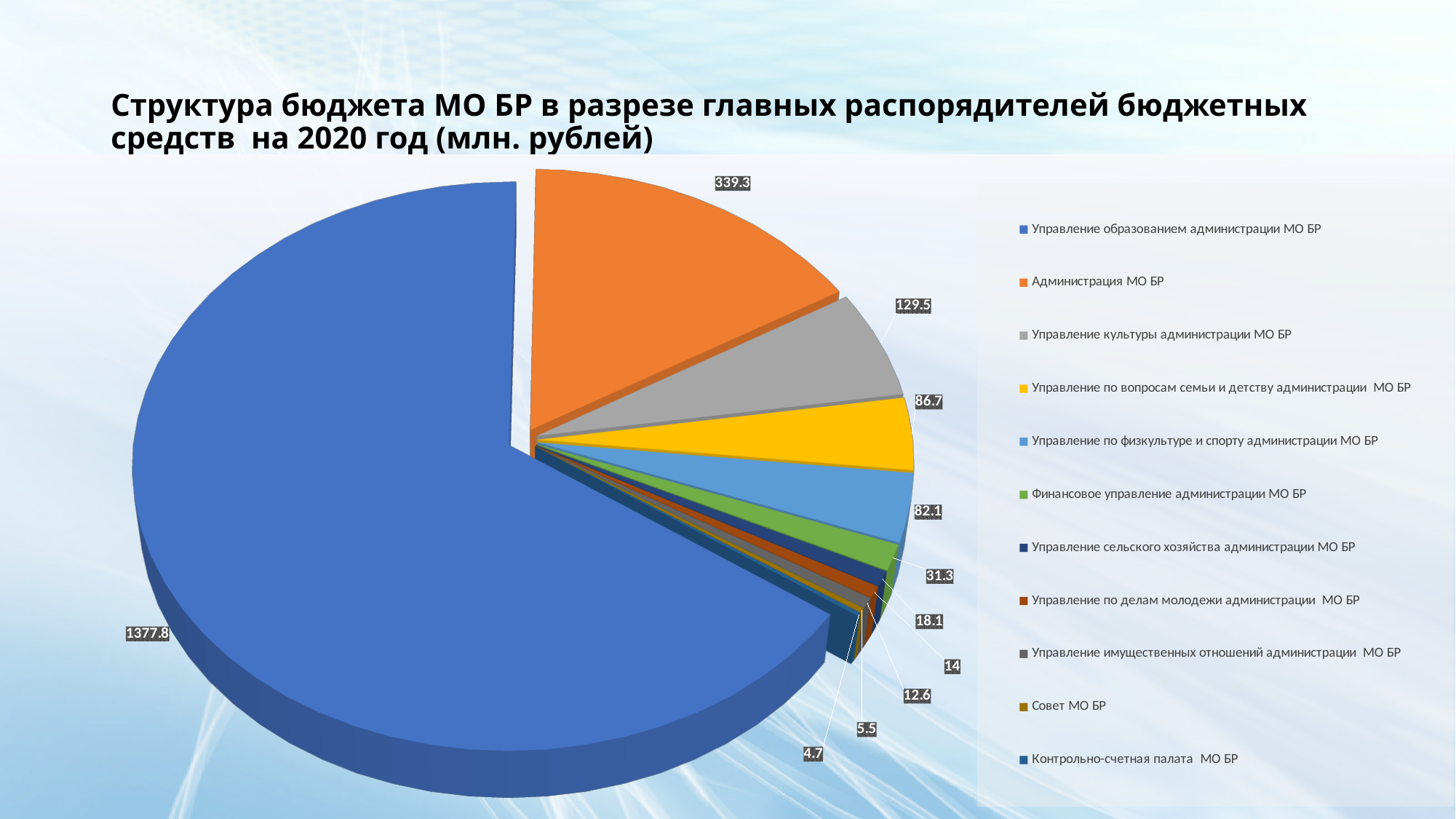
What is the value for Администрация МО БР? 339.3 What unit is stated in the chart title for the values? млн. рублей What is the value for Контрольно-счетная палата МО БР? 4.7 Which is larger: the value for Управление по вопросам семьи и детству администрации МО БР or Финансовое управление администрации МО БР? Управление по вопросам семьи и детству администрации МО БР What is the value for Управление по физкультуре и спорту администрации МО БР? 82.1 What is the value for Управление образованием администрации МО БР? 1377.8 What is the difference between the values for Администрация МО БР and Управление культуры администрации МО БР? 209.8 Which category has the largest slice of the pie? Управление образованием администрации МО БР Which category has the smallest slice of the pie? Контрольно-счетная палата МО БР How many categories does the pie chart show? 11 What kind of chart is shown on the slide? pie chart What is the value for Управление культуры администрации МО БР? 129.5